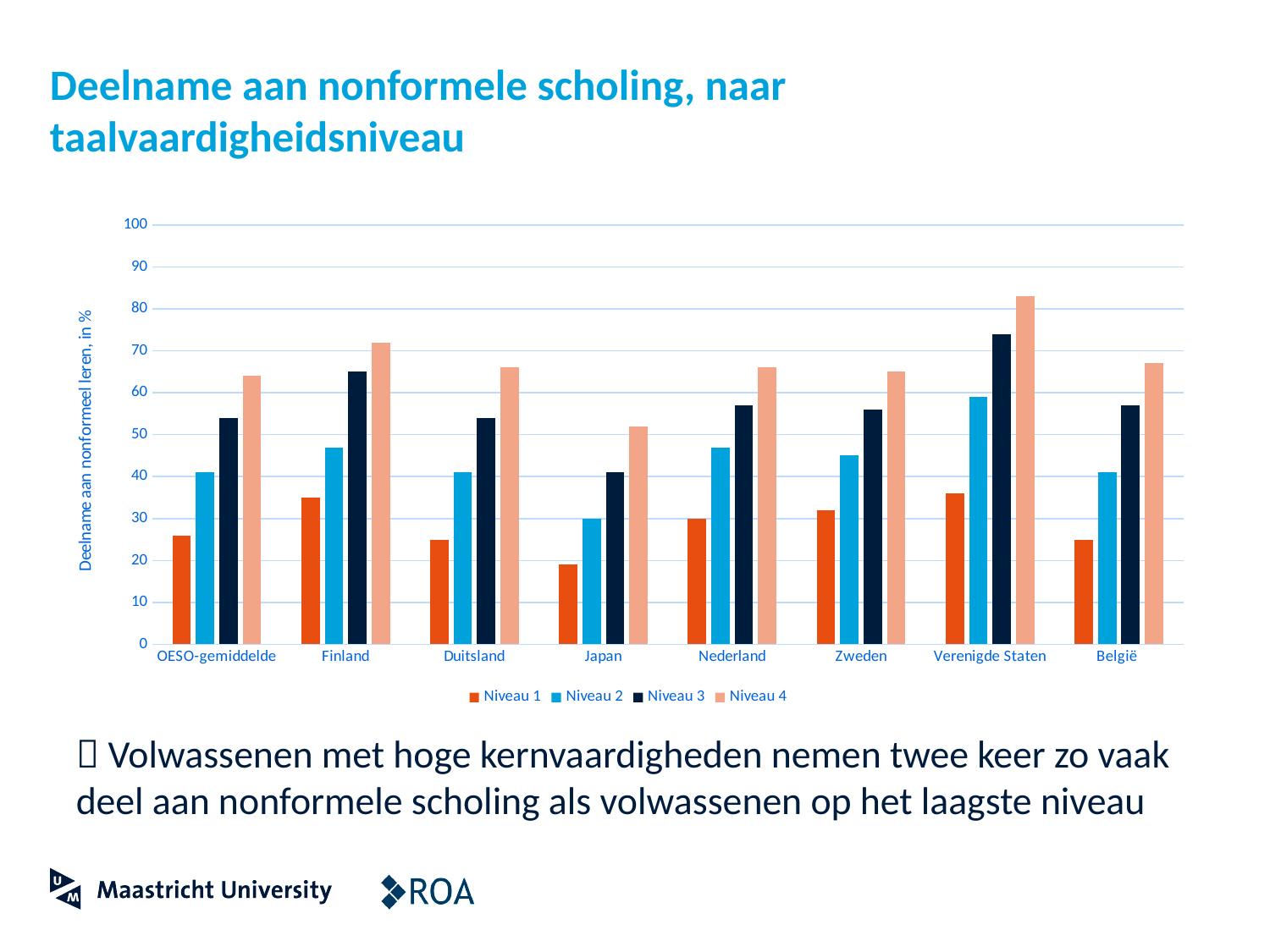
How many series does the legend list? 4 Is the Niveau 3 value for Finland greater or less than 60? greater What kind of chart is shown on the slide? bar chart Which category has the lowest Niveau 1 bar? Japan Is the Niveau 4 value for Verenigde Staten greater or less than 80? greater Which category has the highest Niveau 4 bar? Verenigde Staten What is the label of the y axis? Deelname aan nonformeel leren, in % How many countries/categories are shown on the x axis? 8 Which category has the highest Niveau 3 bar? Verenigde Staten Which is larger: the Niveau 3 value for Finland or the Niveau 3 value for Duitsland? Finland Which is larger: the Niveau 4 value for Japan or the Niveau 4 value for Nederland? Nederland